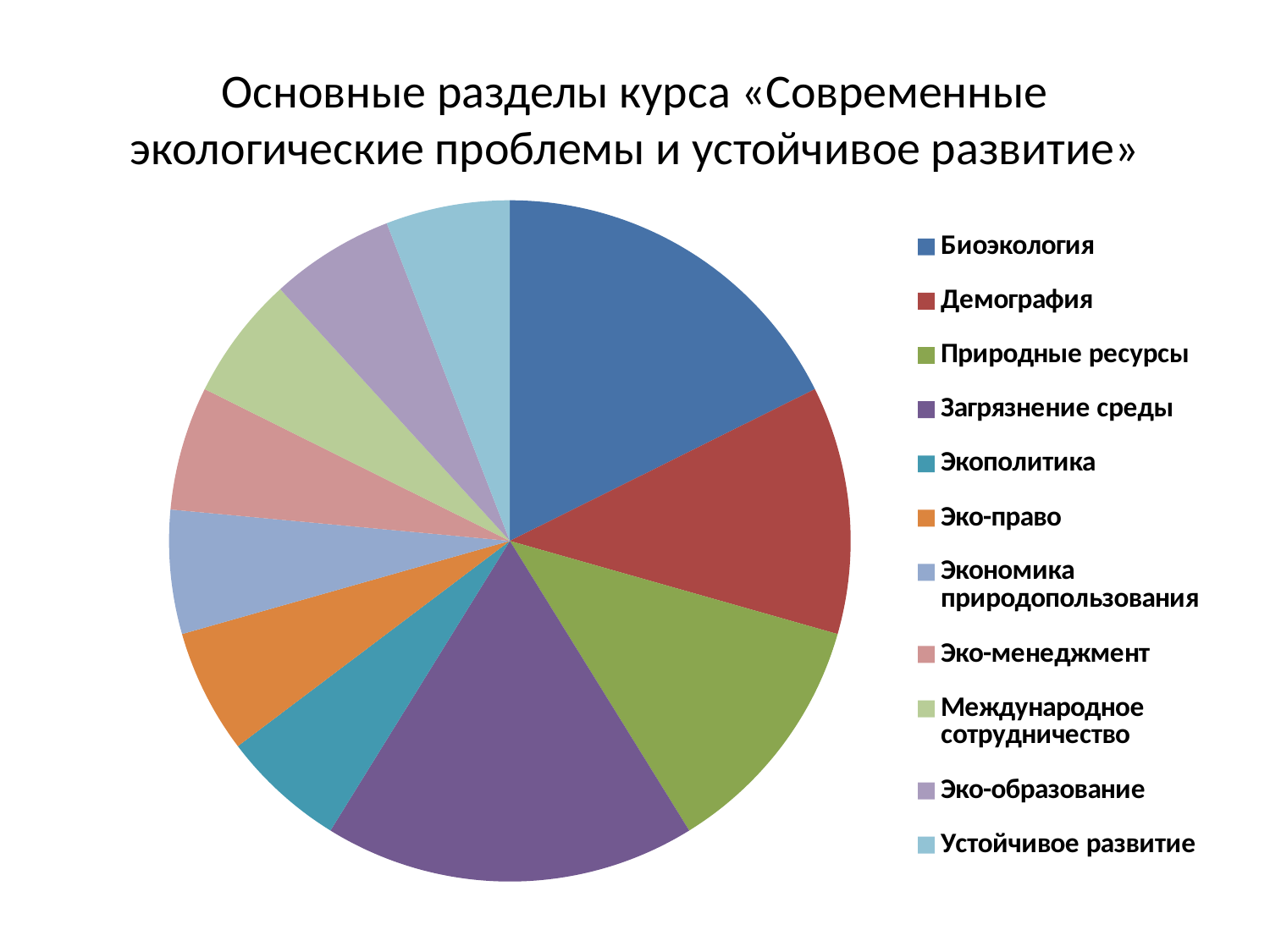
Which slice is larger, Загрязнение среды or Устойчивое развитие? Загрязнение среды Which slice is larger, Загрязнение среды or Эко-образование? Загрязнение среды Which slice is larger, Биоэкология or Международное сотрудничество? Биоэкология What colour is the Биоэкология slice in the pie chart? blue How many slices does the pie chart have? 11 How many entries does the legend of the pie chart list? 11 What is the title of the slide containing the pie chart? Основные разделы курса «Современные экологические проблемы и устойчивое развитие» What kind of chart is shown on the slide? pie chart